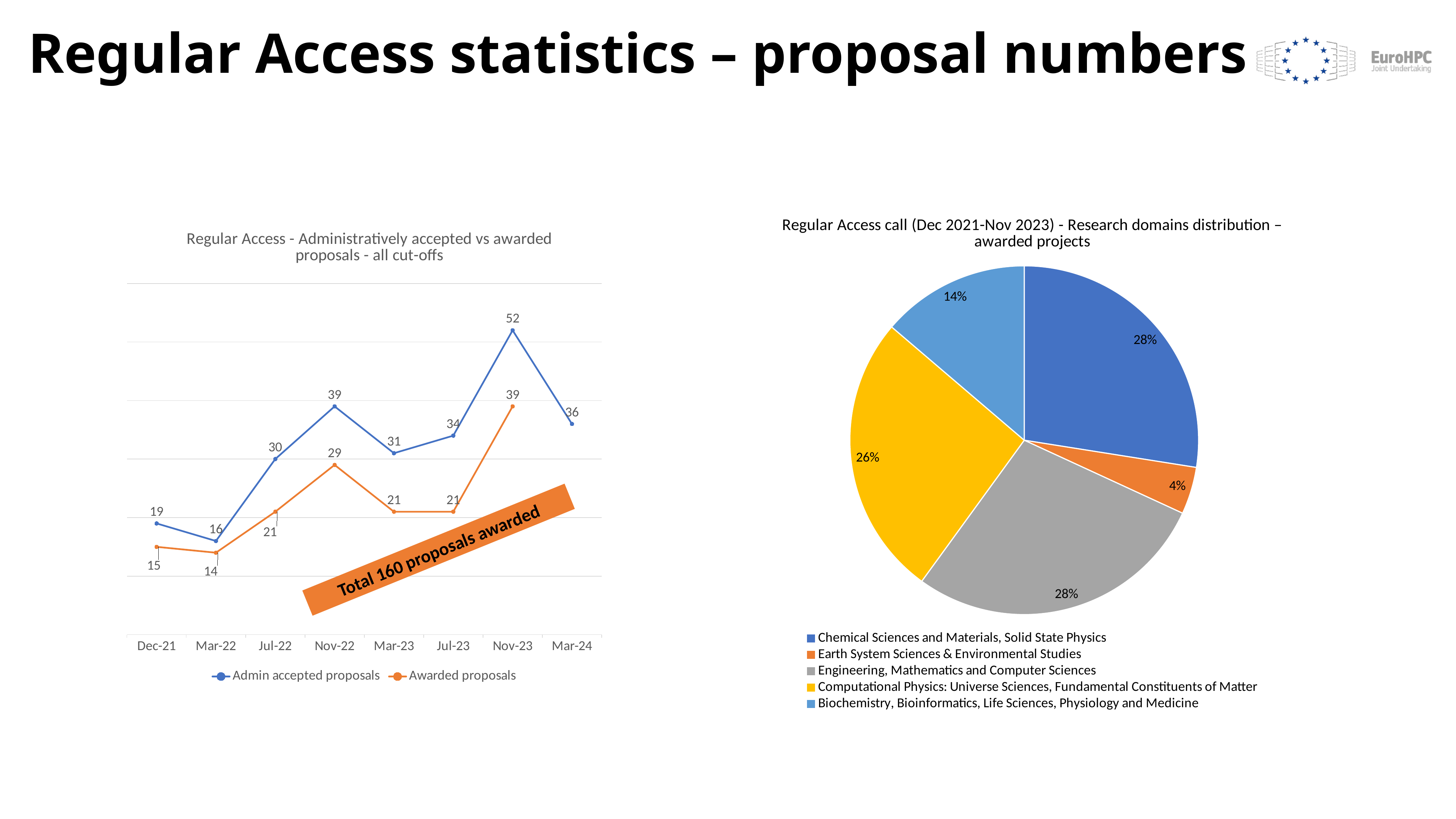
In the pie chart on the right, what share is Computational Physics: Universe Sciences, Fundamental Constituents of Matter? 26% In the line chart on the left, what is the difference between admin accepted and awarded proposals at Nov-23? 13 In the line chart on the left, how many awarded proposals were there at Nov-22? 29 In the pie chart on the right, what share is Earth System Sciences & Environmental Studies? 4% In the line chart on the left, how many series does the legend list? 2 What type of chart is the chart on the left? Line chart In the line chart on the left, how many cut-off dates are shown on the x axis? 8 In the line chart on the left, at which cut-off was the number of admin accepted proposals highest? Nov-23 In the line chart on the left, which is larger: admin accepted proposals at Jul-22 or at Mar-23? Mar-23 In the pie chart on the right, which research domain has the smallest share? Earth System Sciences & Environmental Studies In the line chart on the left, how many admin accepted proposals were there at Nov-23? 52 In the line chart on the left, at which cut-off was the number of awarded proposals lowest? Mar-22